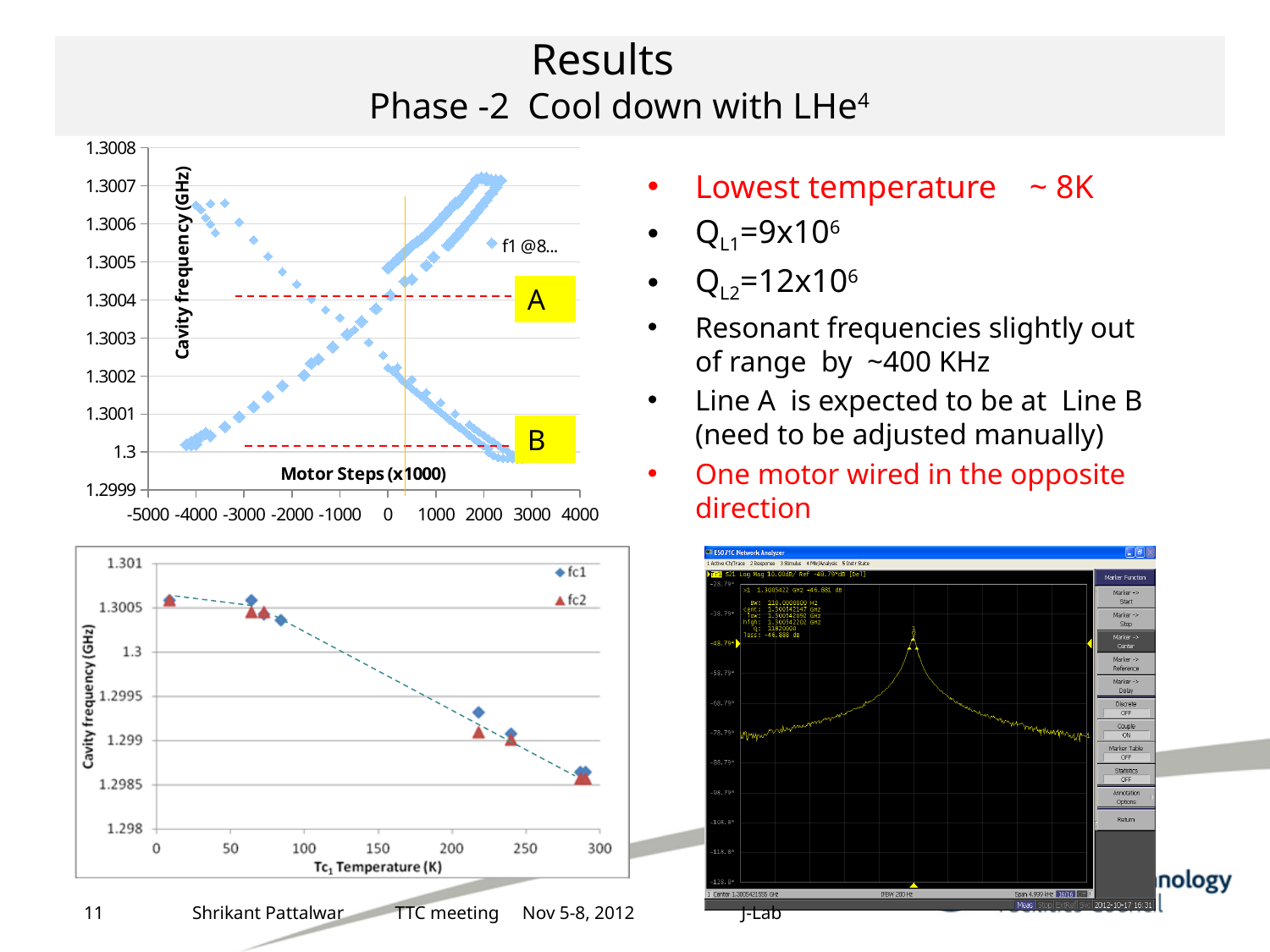
What kind of chart is the bottom-left chart (Cavity frequency vs Tc1 Temperature)? scatter chart In the bottom-left chart, is the fc1 value at about 290 K greater or less than 1.299? less In the bottom-left chart, is the fc2 value at about 220 K greater or less than 1.2995? less What is the highest tick value shown on the y-axis of the top-left chart? 1.3008 In the bottom-left chart, do the cavity frequency values rise or fall as Tc1 temperature increases? fall In the top-left chart, is the highest plotted cavity frequency greater or less than 1.3006? greater What kind of chart is the top-left chart (Cavity frequency vs Motor Steps)? scatter chart How many series does the legend of the bottom-left chart list? 2 What is the x-axis title of the top-left chart? Motor Steps (x1000) In the top-left chart, which dashed line is at a higher cavity frequency, Line A or Line B? Line A What are the legend entries of the bottom-left chart? fc1, fc2